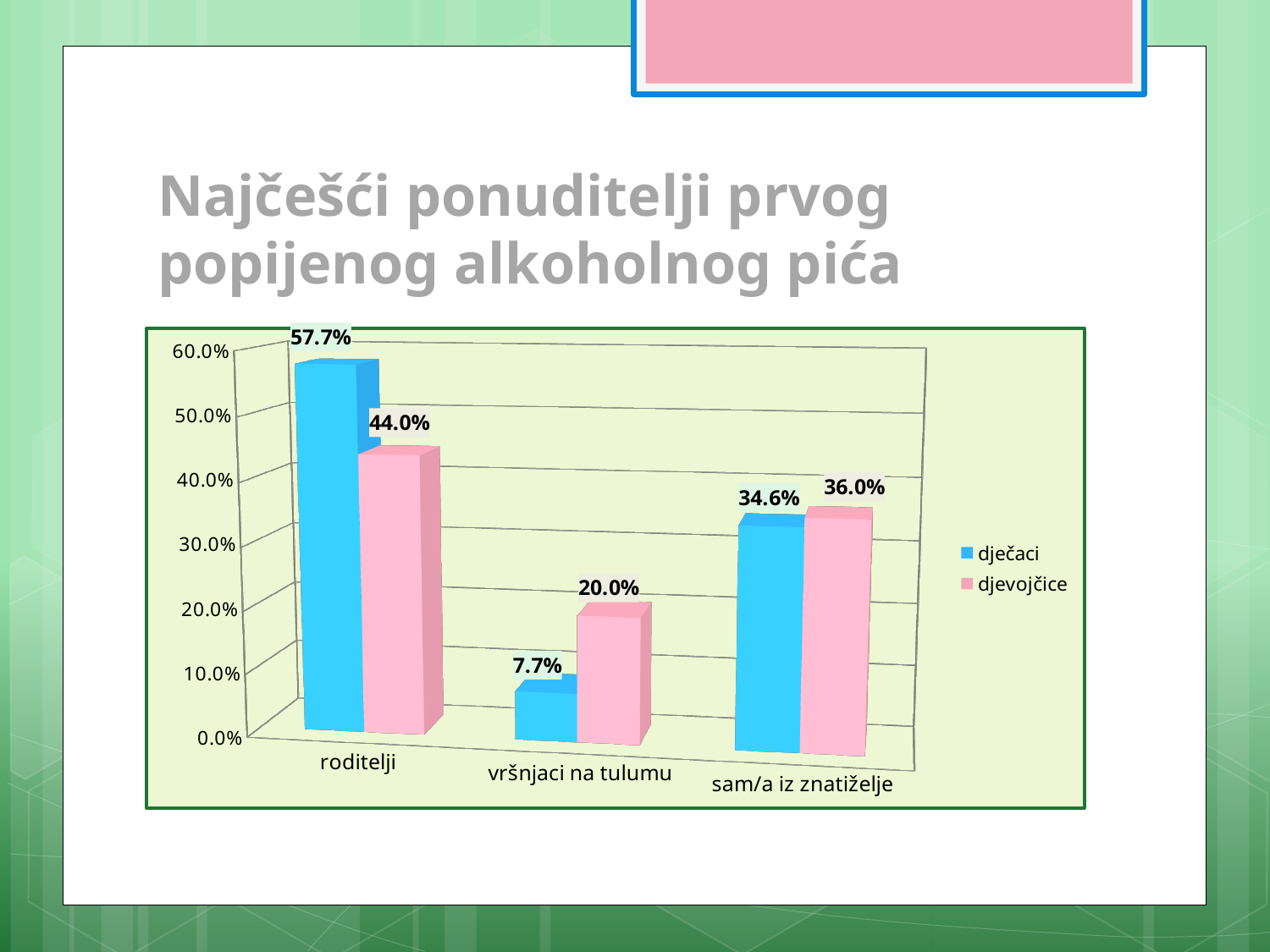
In the sam/a iz znatiželje category, which series has the larger value, dječaci or djevojčice? djevojčice Which category has the lowest value for dječaci? vršnjaci na tulumu Is the value for djevojčice in the roditelji category greater or less than 40.0%? greater What is the value for djevojčice in the vršnjaci na tulumu category? 20.0% What is the value for dječaci in the roditelji category? 57.7% Which category has the highest value for djevojčice? roditelji How many series does the legend list? 2 What colour represents the djevojčice series? pink What is the difference between the dječaci and djevojčice values in the roditelji category? 13.7% What is the value for dječaci in the sam/a iz znatiželje category? 34.6% How many categories are shown on the x axis? 3 What kind of chart is shown on the slide? bar chart